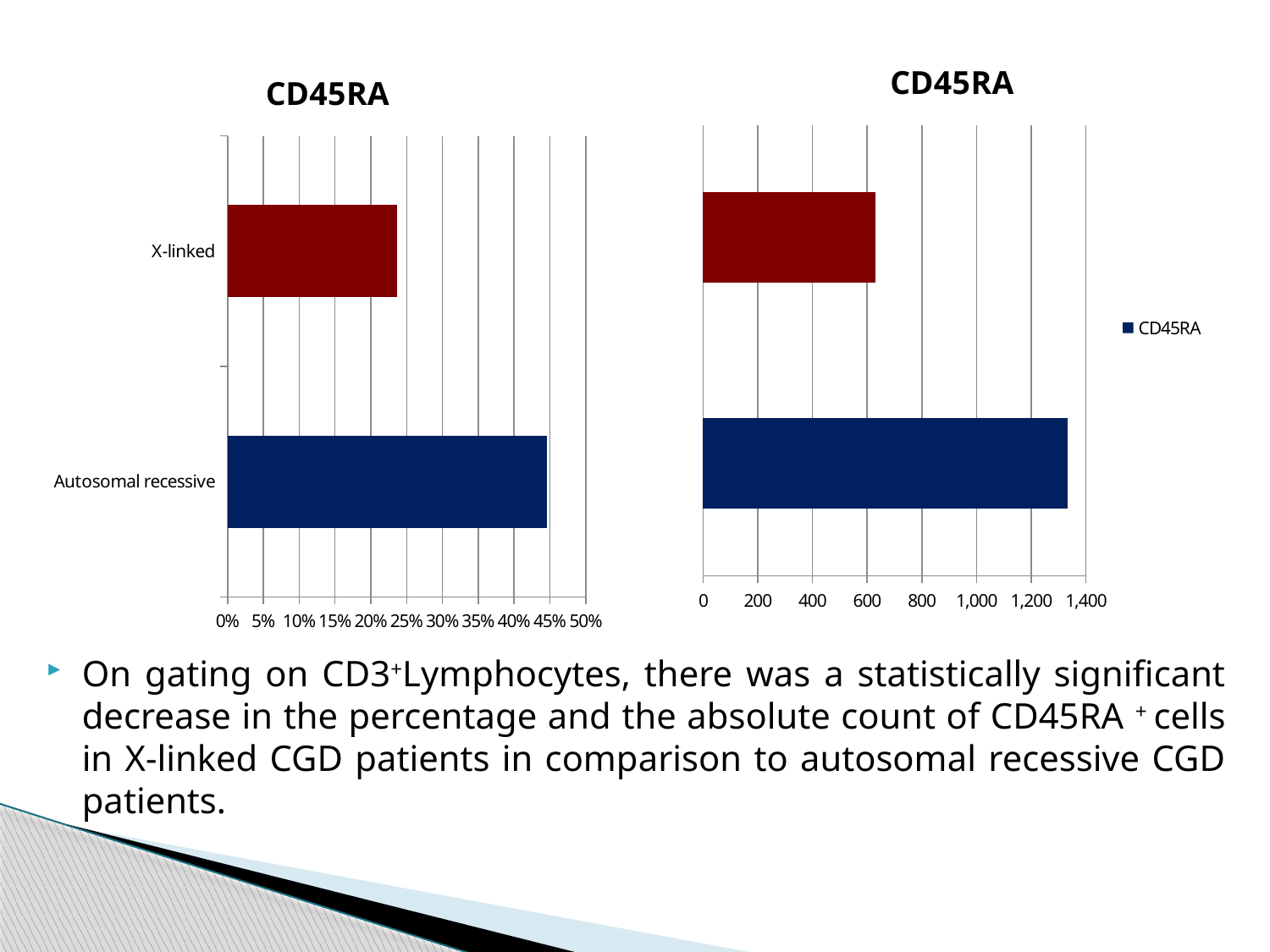
In the left chart (percentage axis), which category has the lower value? X-linked In the left chart (percentage axis), is the value for X-linked greater or less than 30%? less In the left chart (percentage axis), is the value for Autosomal recessive greater or less than 40%? greater In the right chart (count axis), is the value for X-linked larger or smaller than the value for Autosomal recessive? smaller In the right chart (count axis), is the value for Autosomal recessive greater or less than 1,200? greater How many series does the legend of the right chart list? 1 In the left chart (percentage axis), how many categories are shown? 2 What is the title of the right chart? CD45RA In the right chart (count axis), which category has the higher value? Autosomal recessive What kind of chart is the left chart titled CD45RA? bar chart In the left chart (percentage axis), which category has the higher value? Autosomal recessive